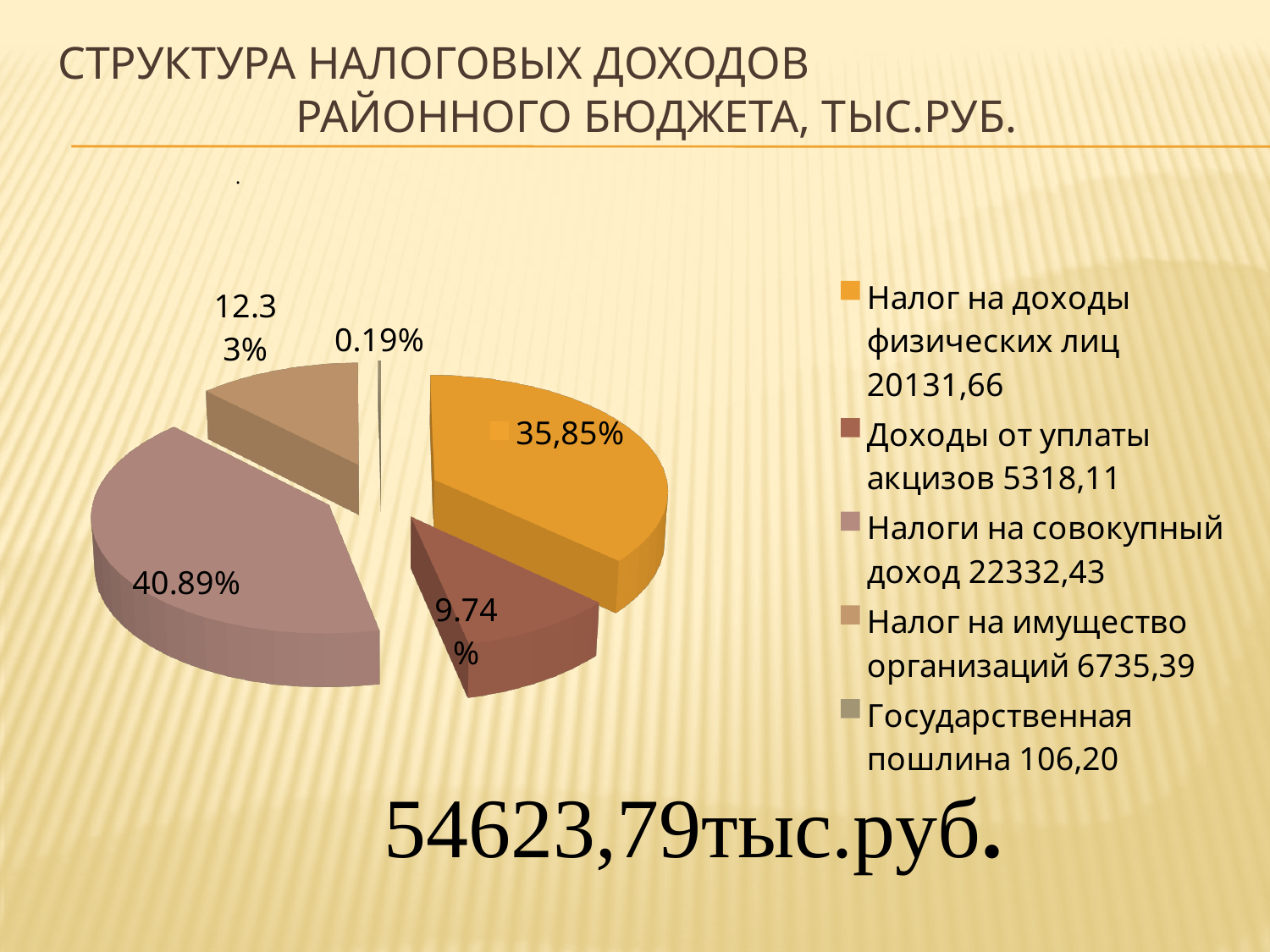
Which category has the smallest slice of the pie? Государственная пошлина What share of the pie does "Государственная пошлина" take? 0.19% What value (тыс.руб.) does the legend give for "Налог на имущество организаций"? 6735,39 What share of the pie does "Налог на доходы физических лиц" take? 35,85% What total amount is printed below the chart? 54623,79тыс.руб. How many slices does the pie chart have? 5 How many entries does the legend list? 5 What share of the pie does "Доходы от уплаты акцизов" take? 9.74% Which is larger: the slice for "Налог на имущество организаций" or the slice for "Доходы от уплаты акцизов"? Налог на имущество организаций What kind of chart is shown on the slide? Pie chart Which category has the largest slice of the pie? Налоги на совокупный доход